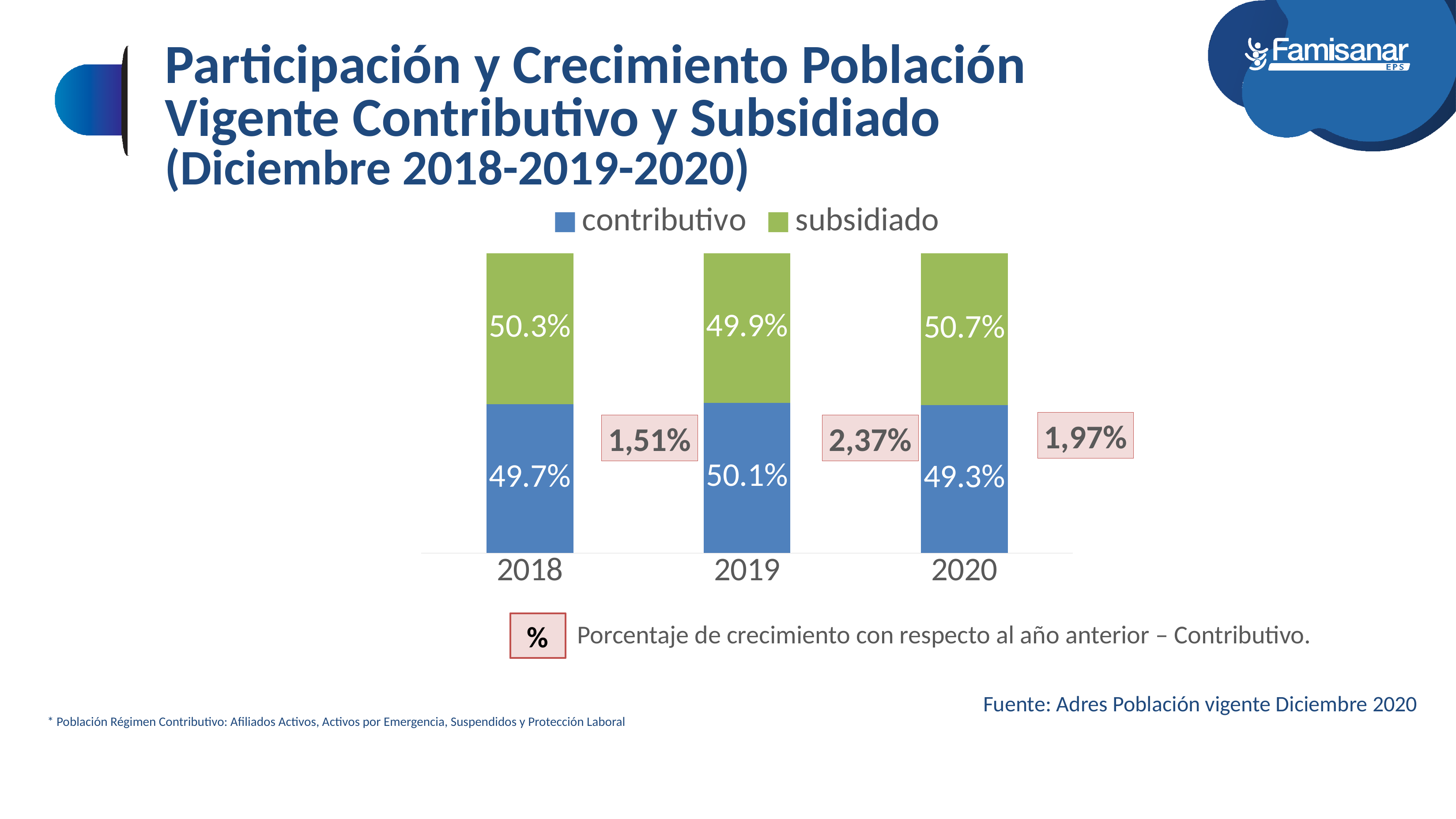
In 2018, which is larger, contributivo or subsidiado? subsidiado What is the contributivo value for 2019? 50.1% What is the subsidiado value for 2020? 50.7% What kind of chart is shown? stacked bar chart What colour represents subsidiado in the chart? green How many series does the legend list? 2 What is the difference between the subsidiado and contributivo values in 2020? 1.4% In which year is the subsidiado share lowest? 2019 What is the contributivo value for 2018? 49.7% What is the subsidiado value for 2019? 49.9% How many years are shown on the x axis? 3 In which year is the contributivo share highest? 2019